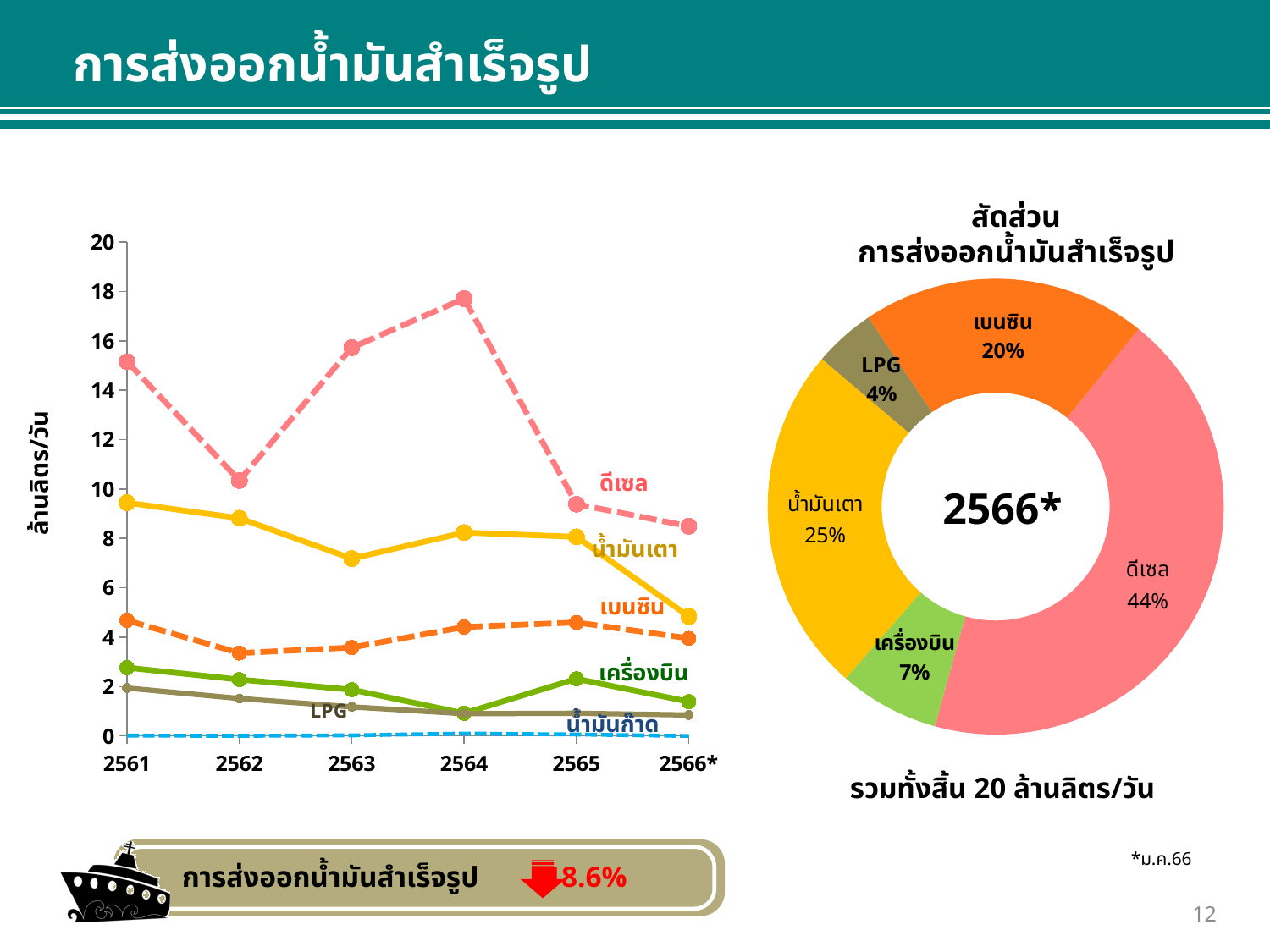
In the line chart on the left, what kind of chart is it? line chart In the donut chart titled สัดส่วน การส่งออกน้ำมันสำเร็จรูป, what year is shown in the centre of the chart? 2566* In the line chart on the left, is the value for น้ำมันเตา in 2566* greater or less than 6? less In the donut chart titled สัดส่วน การส่งออกน้ำมันสำเร็จรูป, what is the difference between the shares of น้ำมันเตา and เบนซิน? 5% In the line chart on the left, how many years are shown on the x axis? 6 In the donut chart titled สัดส่วน การส่งออกน้ำมันสำเร็จรูป, which category has the smallest share? LPG In the donut chart titled สัดส่วน การส่งออกน้ำมันสำเร็จรูป, what share does ดีเซล have? 44% In the line chart on the left, how many series are labelled? 6 In the line chart on the left, is the value for ดีเซล in 2564 greater or less than 16? greater In the line chart on the left, in which year does ดีเซล reach its highest value? 2564 In the line chart on the left, which series has the highest value in 2561, ดีเซล or น้ำมันเตา? ดีเซล In the line chart on the left, is the value for ดีเซล in 2561 greater or less than 14? greater